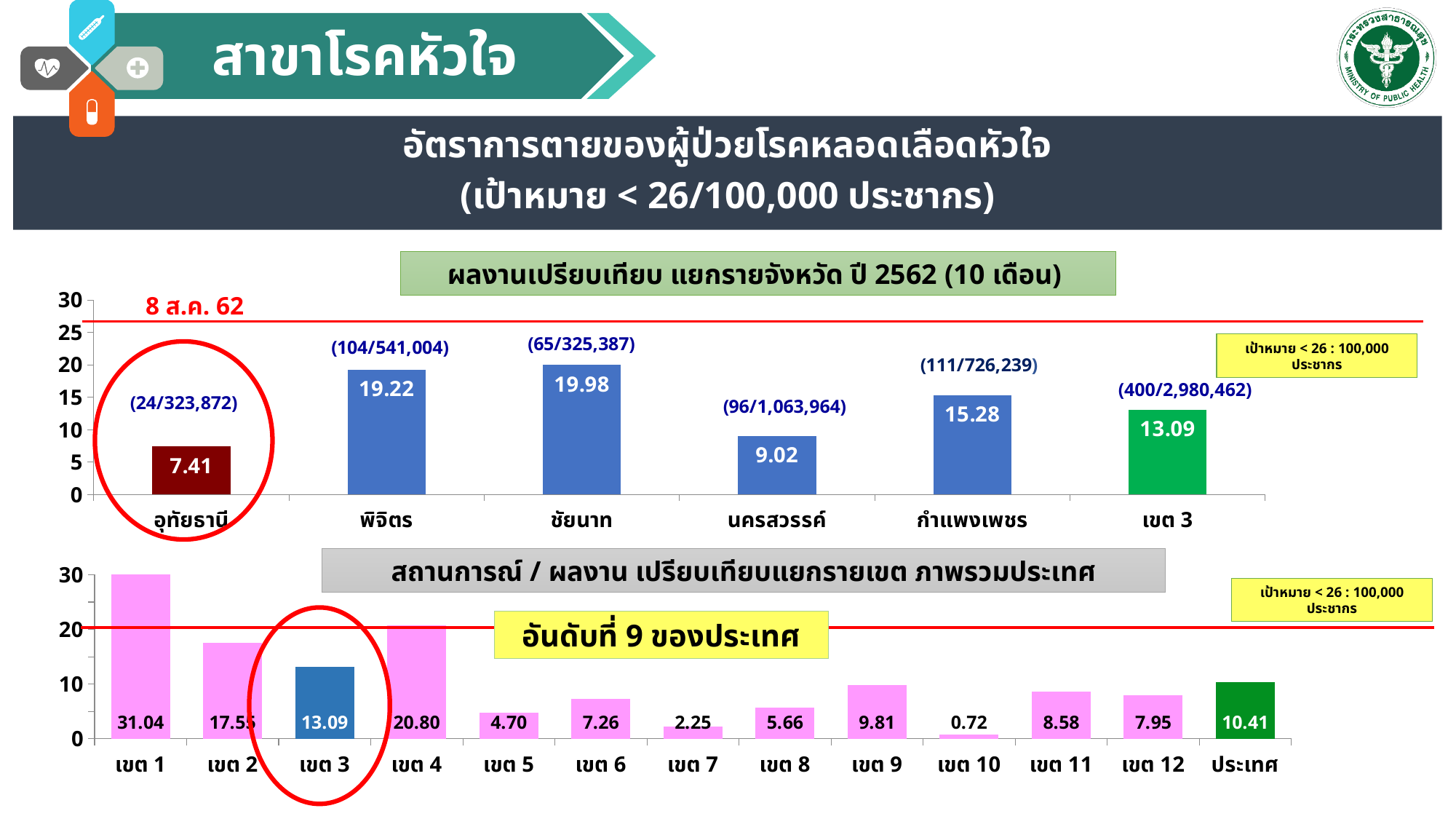
In the top chart (ผลงานเปรียบเทียบ แยกรายจังหวัด ปี 2562), what is the value for พิจิตร? 19.22 What kind of chart is the bottom chart (สถานการณ์ / ผลงาน เปรียบเทียบแยกรายเขต ภาพรวมประเทศ)? bar chart In the top chart (ผลงานเปรียบเทียบ แยกรายจังหวัด ปี 2562), which province has the lowest value? อุทัยธานี In the top chart (ผลงานเปรียบเทียบ แยกรายจังหวัด ปี 2562), which category has the highest value? ชัยนาท In the bottom chart (สถานการณ์ / ผลงาน เปรียบเทียบแยกรายเขต ภาพรวมประเทศ), what is the value for ประเทศ? 10.41 In the top chart (ผลงานเปรียบเทียบ แยกรายจังหวัด ปี 2562), what is the difference between the values for กำแพงเพชร and นครสวรรค์? 6.26 In the top chart (ผลงานเปรียบเทียบ แยกรายจังหวัด ปี 2562), how many bars are plotted? 6 In the bottom chart (สถานการณ์ / ผลงาน เปรียบเทียบแยกรายเขต ภาพรวมประเทศ), what is the value for เขต 1? 31.04 In the bottom chart (สถานการณ์ / ผลงาน เปรียบเทียบแยกรายเขต ภาพรวมประเทศ), what is the difference between the values for เขต 4 and เขต 3? 7.71 In the bottom chart (สถานการณ์ / ผลงาน เปรียบเทียบแยกรายเขต ภาพรวมประเทศ), which category has the lowest value? เขต 10 In the top chart (ผลงานเปรียบเทียบ แยกรายจังหวัด ปี 2562), what is the value for เขต 3? 13.09 In the bottom chart (สถานการณ์ / ผลงาน เปรียบเทียบแยกรายเขต ภาพรวมประเทศ), which is larger, the value for เขต 9 or the value for เขต 11? เขต 9